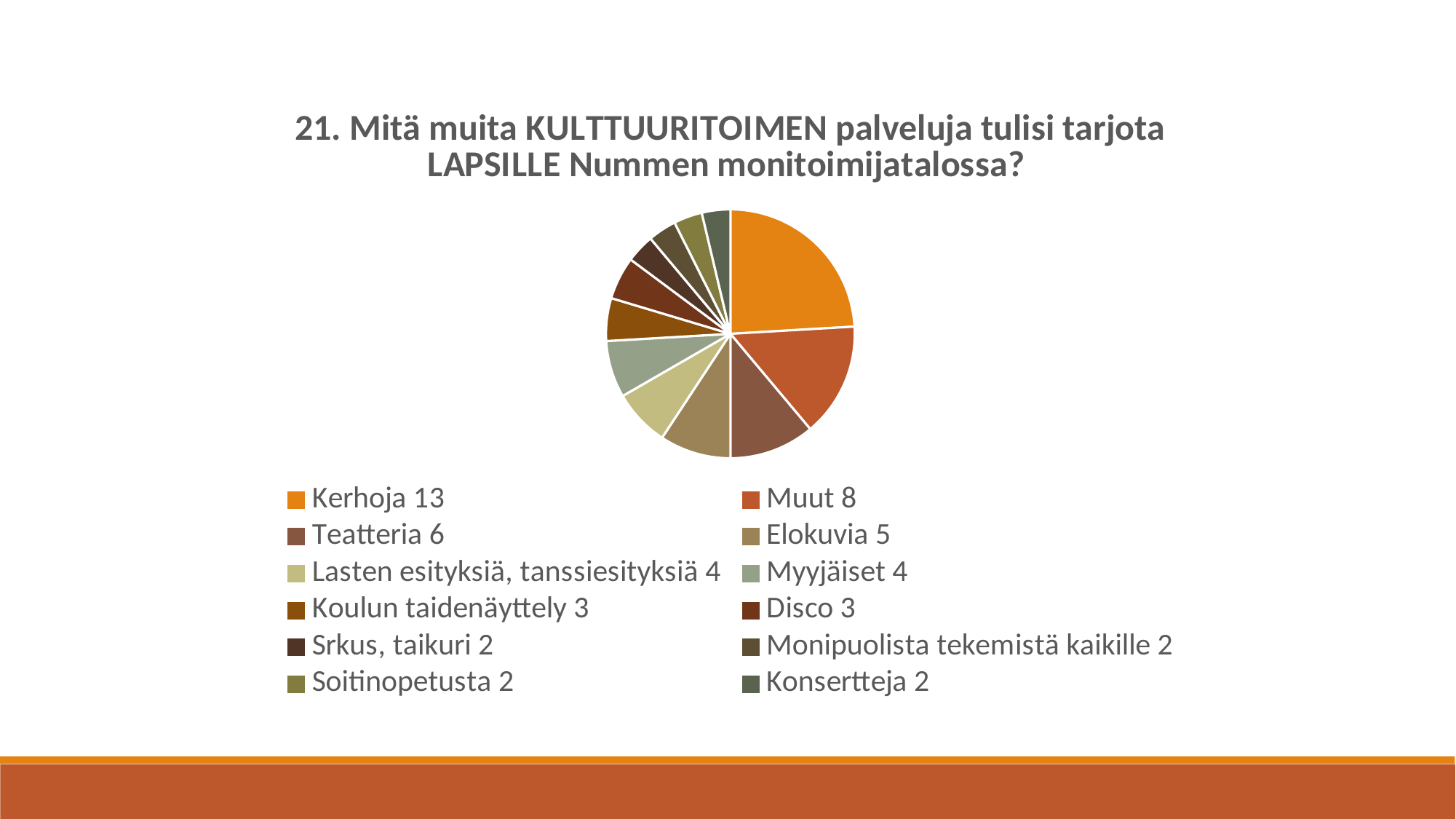
What is the total of all the values shown in the legend of the pie chart? 54 What is the value for Teatteria? 6 How many categories does the pie chart have? 12 What is the difference between the values for Kerhoja and Muut? 5 What kind of chart is shown on the slide? pie chart What is the value for Elokuvia? 5 What is the value for Kerhoja? 13 Which is larger, the value for Teatteria or the value for Elokuvia? Teatteria Which category has the largest slice of the pie chart? Kerhoja What is the value for Koulun taidenäyttely? 3 What is the title of the chart? 21. Mitä muita KULTTUURITOIMEN palveluja tulisi tarjota LAPSILLE Nummen monitoimijatalossa? What is the value for Muut? 8